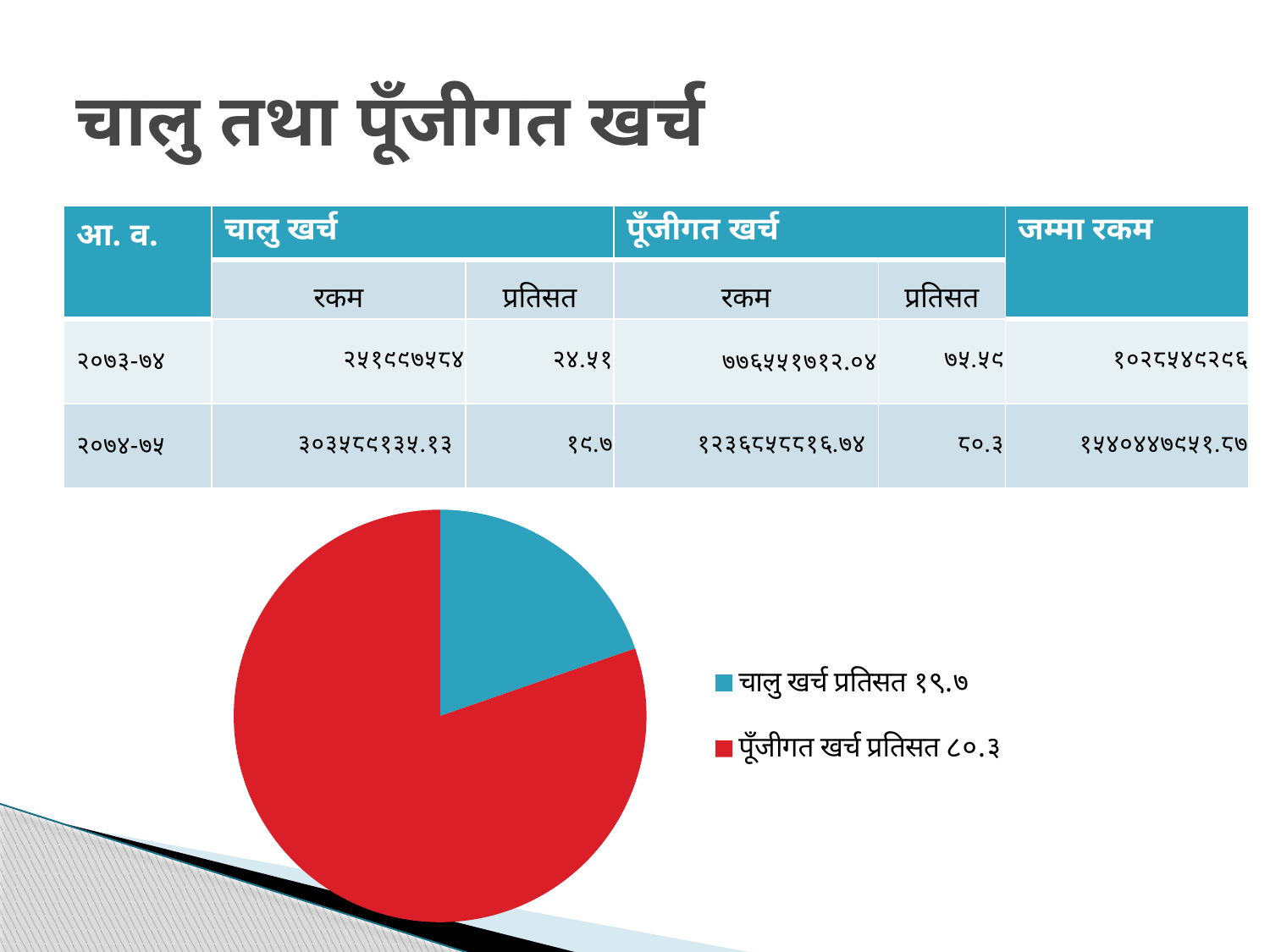
Which is larger in the pie chart, चालु खर्च प्रतिसत or पूँजीगत खर्च प्रतिसत? पूँजीगत खर्च प्रतिसत How many slices does the pie chart have? 2 How many entries does the pie chart's legend list? 2 What kind of chart is shown on the slide? pie chart Which slice of the pie chart is the largest? पूँजीगत खर्च प्रतिसत What value does the legend give for चालु खर्च प्रतिसत? १९.७ What value does the legend give for पूँजीगत खर्च प्रतिसत? ८०.३ What colour is the चालु खर्च प्रतिसत slice in the pie chart? blue What colour is the पूँजीगत खर्च प्रतिसत slice in the pie chart? red Which slice of the pie chart is the smallest? चालु खर्च प्रतिसत